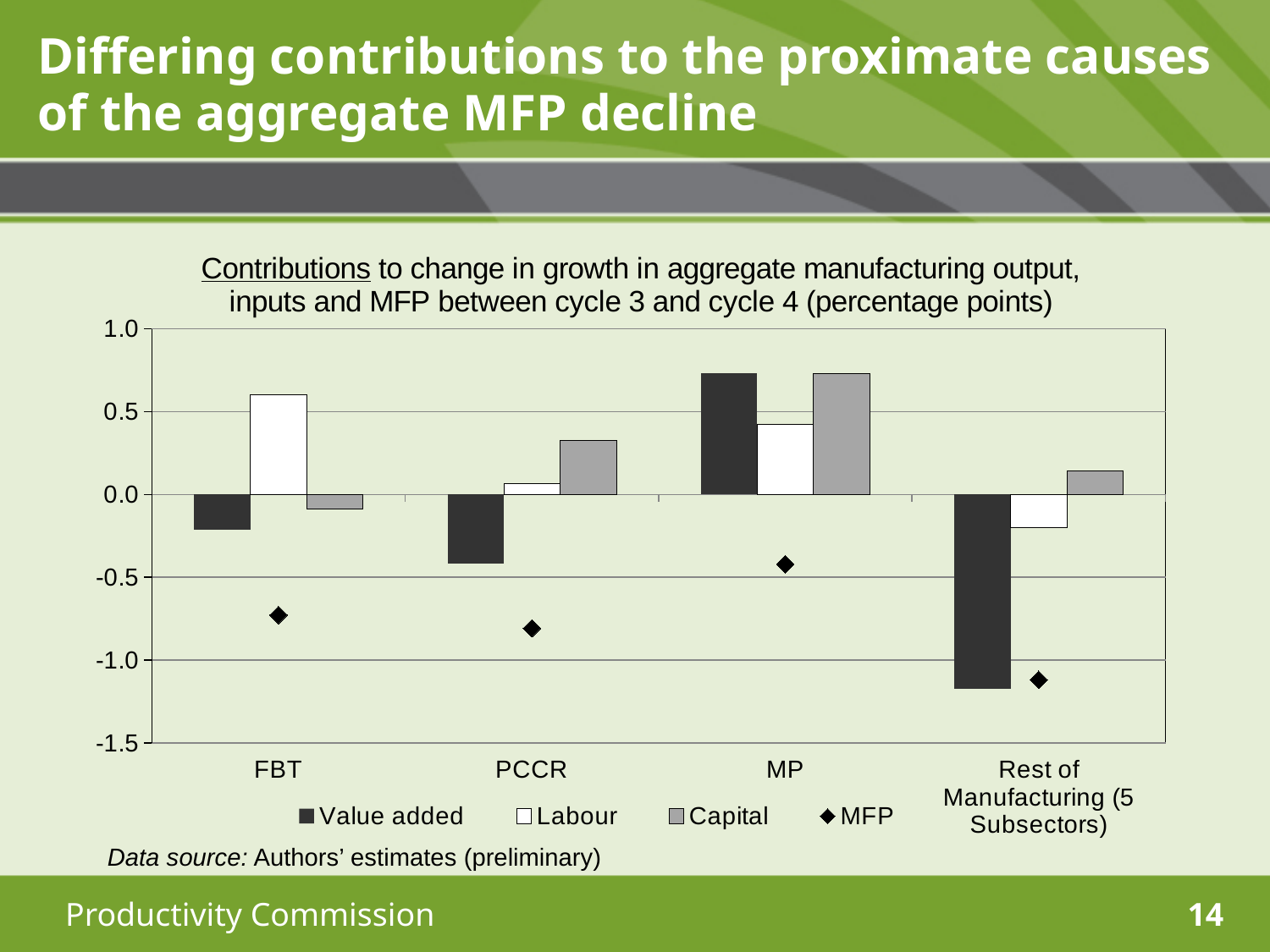
How many series does the chart's legend list? 4 How many categories are shown on the x axis of the chart? 4 Which category has the lowest Value added value? Rest of Manufacturing (5 Subsectors) Is the Capital value for PCCR greater or less than 0.5? less What kind of chart is shown on the slide? Bar chart What marker shape is used for the MFP series in the chart? Diamond Which is larger, the Labour value for FBT or the Labour value for MP? FBT Is the Value added value for Rest of Manufacturing (5 Subsectors) greater or less than -1.0? less Is the MFP value for MP greater or less than -0.5? greater Which category has the lowest MFP value? Rest of Manufacturing (5 Subsectors) Which category has the highest Value added value? MP